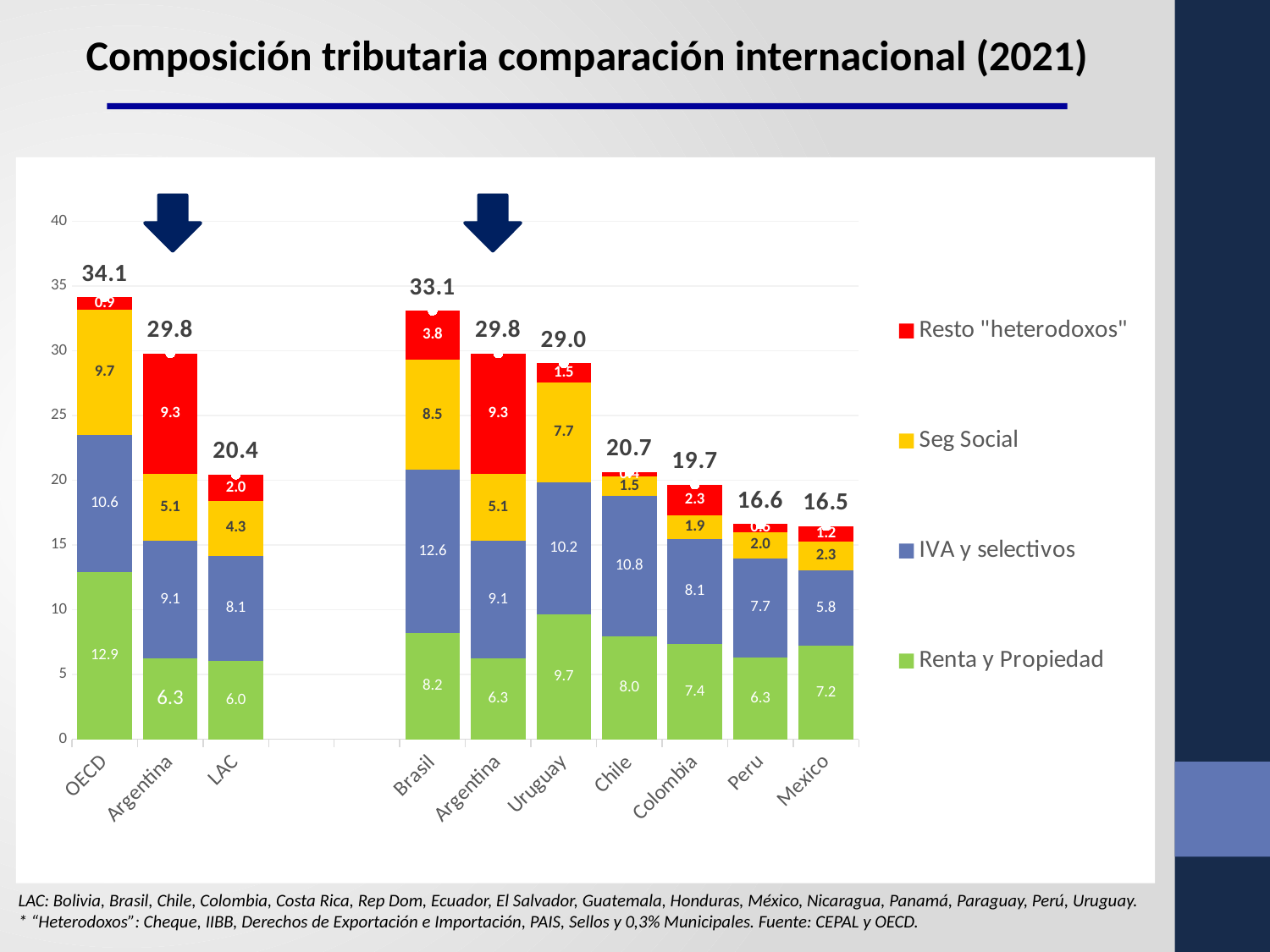
What kind of chart is shown on the slide? Stacked bar chart What is the difference between the total for OECD and the total for LAC? 13.7 Which bar has the highest total on the chart? OECD Which is larger, the Resto "heterodoxos" value for Argentina or for Brasil? Argentina Which country among Brasil, Uruguay, Chile, Colombia, Peru and Mexico has the lowest total? Mexico Which legend entry is shown in green? Renta y Propiedad What is the IVA y selectivos value for Uruguay? 10.2 What is the Renta y Propiedad value for Brasil? 8.2 What is the Seg Social value for Argentina? 5.1 Is the total for Colombia greater or less than 20? less What is the total value printed above the OECD bar? 34.1 How many series does the legend list? 4